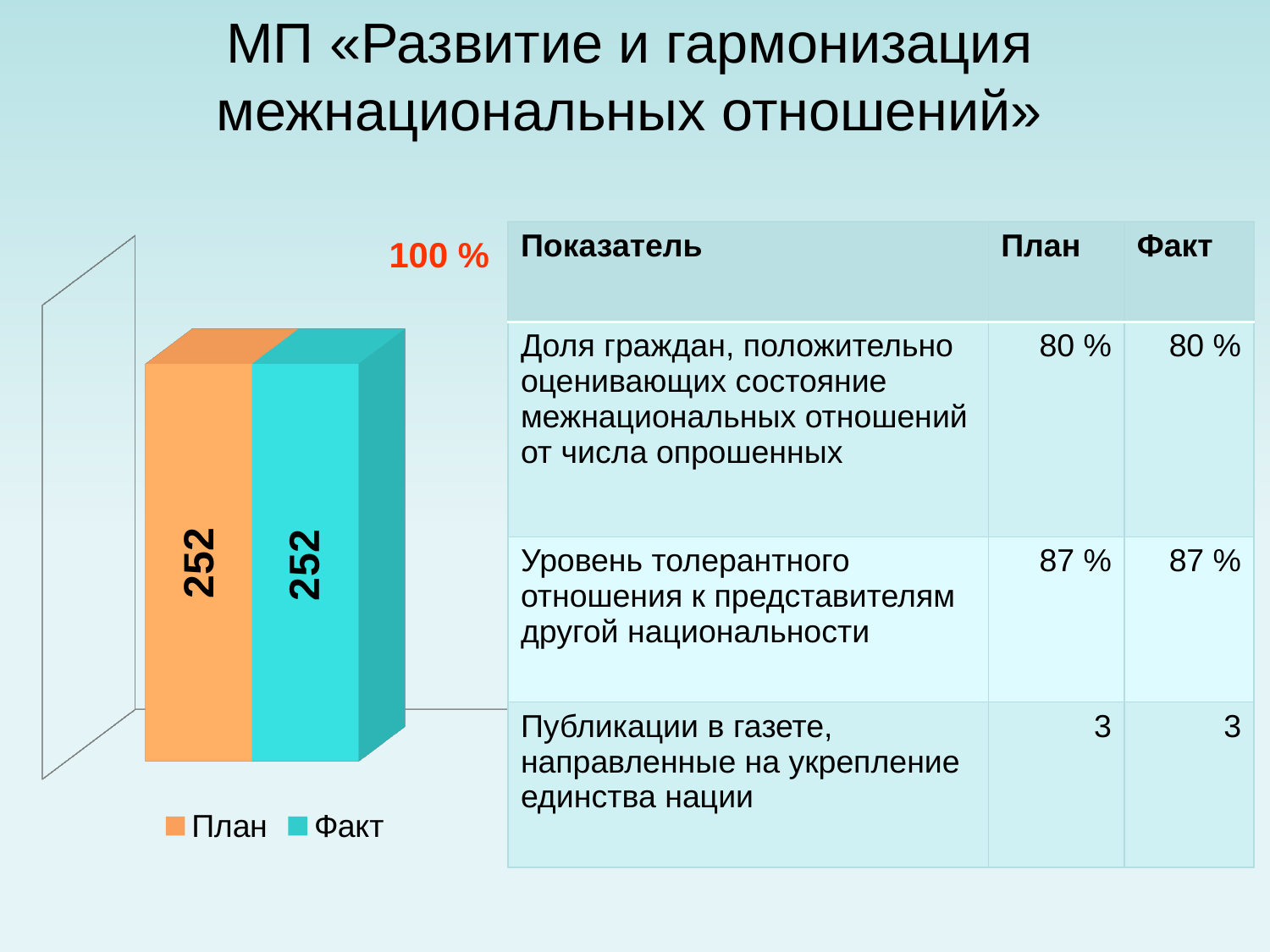
How many series does the chart legend list? 2 What kind of chart is shown on the slide? bar chart What is the value of the План bar in the chart? 252 How many bars are plotted in the chart? 2 What is the value of the Факт bar in the chart? 252 Which series in the chart legend is shown in turquoise? Факт Which series in the chart legend is shown in orange? План What is the difference between the План and Факт values in the chart? 0 Are the План and Факт values in the chart equal? Yes What percentage label is printed in red above the chart? 100 %